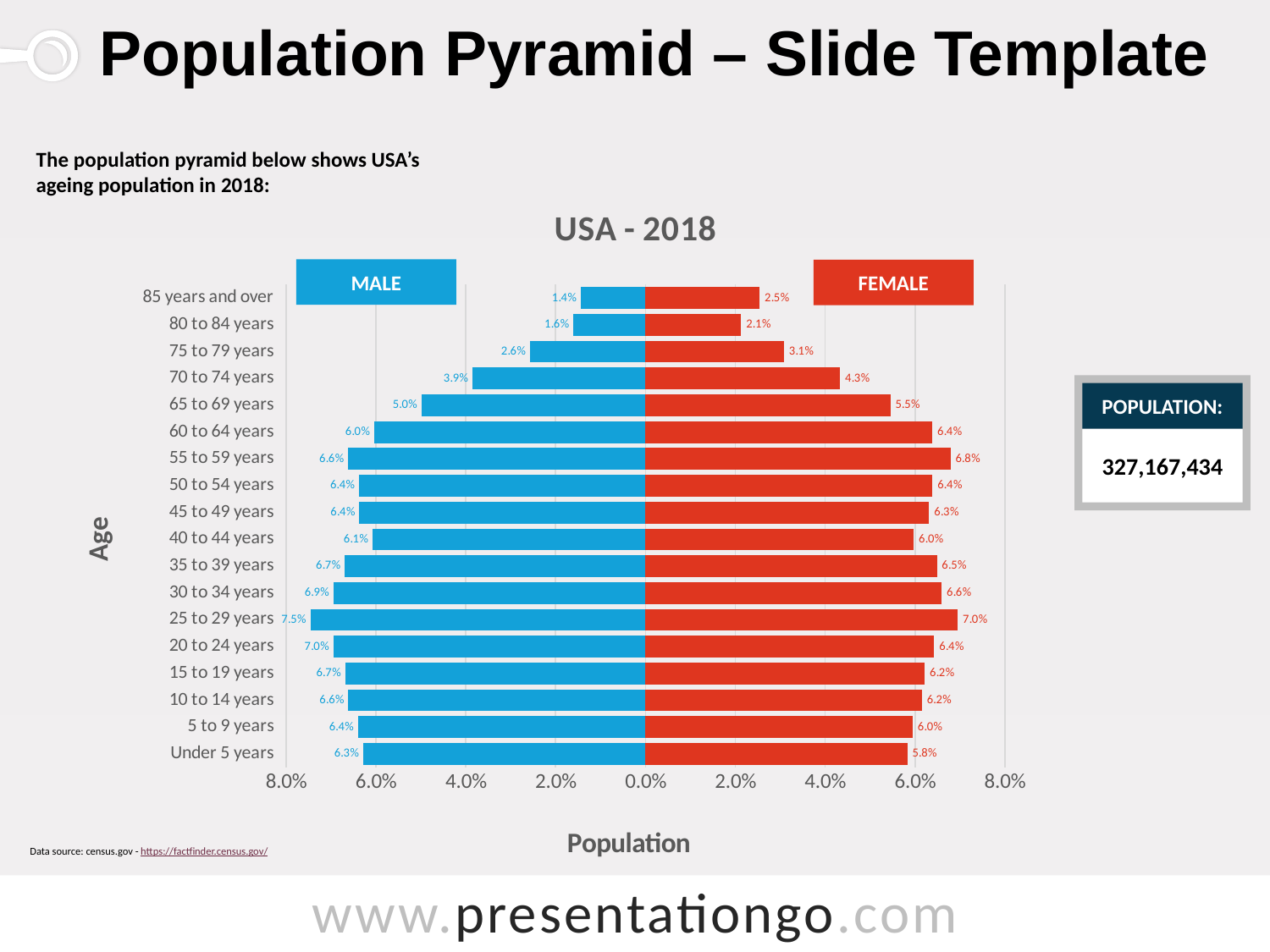
What is the title of the chart? USA - 2018 Which age group has the lowest female value? 80 to 84 years Which age group has the highest female value? 25 to 29 years Which age group has the lowest male value? 85 years and over What is the difference between the male and female values for the 85 years and over group? 1.1% How many series does the chart show? 2 What kind of chart is shown on the slide? Bar chart (population pyramid) What is the male value for the 25 to 29 years age group? 7.5% How many age groups are shown on the chart? 18 What is the female value for the 65 to 69 years age group? 5.5% What is the male value for the 70 to 74 years age group? 3.9% Which is larger for the 20 to 24 years group, the male value or the female value? Male